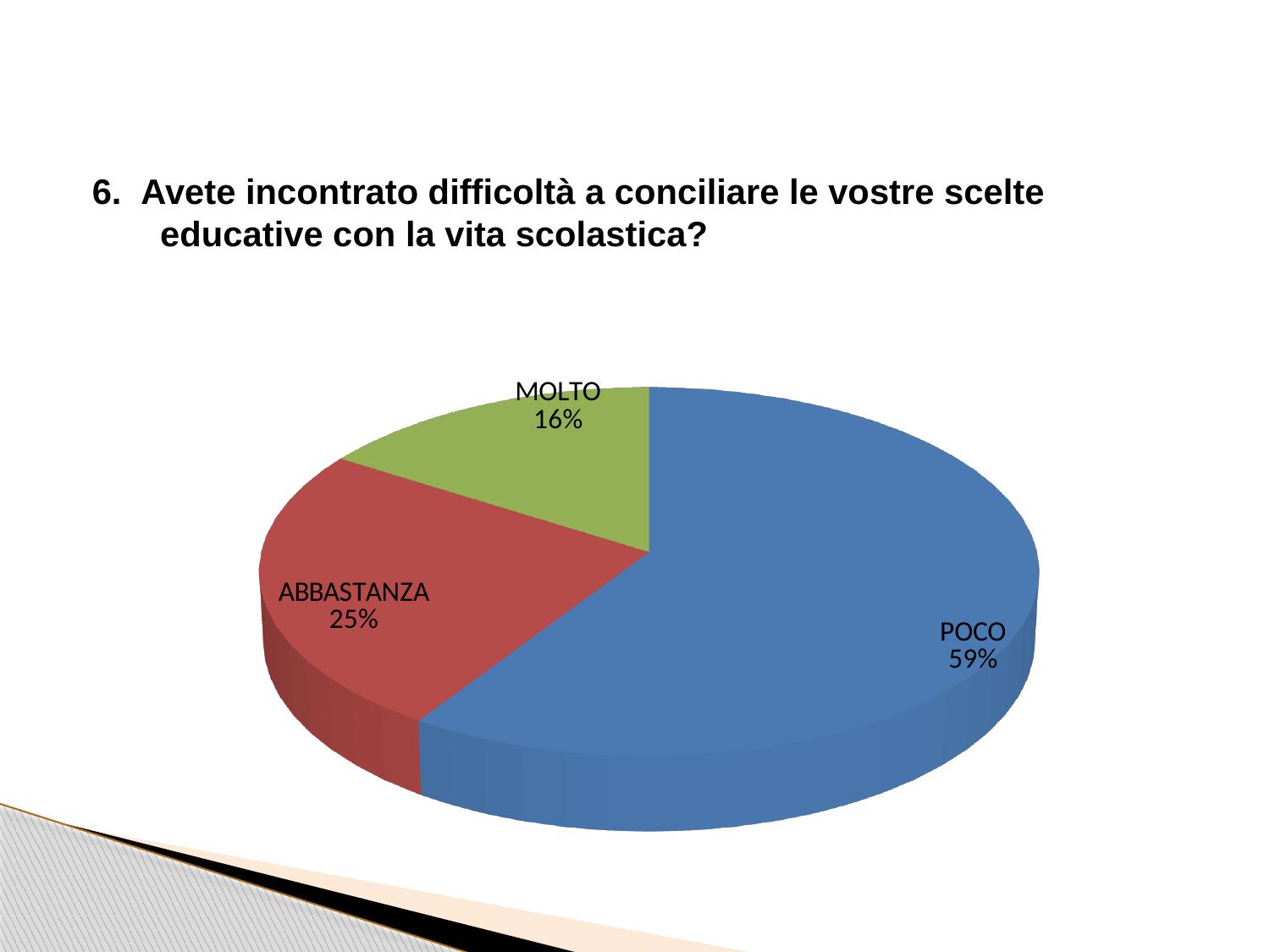
What is the combined share of ABBASTANZA and MOLTO? 41% What is the difference in percentage points between POCO and ABBASTANZA? 34 What kind of chart is shown on the slide? pie chart What colour is the POCO slice? blue Which response has the smallest share of the pie? MOLTO What percentage of respondents answered MOLTO? 16% Which response has the largest share of the pie? POCO Which is larger, the share for ABBASTANZA or the share for MOLTO? ABBASTANZA What is the difference in percentage points between ABBASTANZA and MOLTO? 9 What percentage of respondents answered ABBASTANZA? 25% What percentage of respondents answered POCO? 59% How many slices does the pie chart have? 3